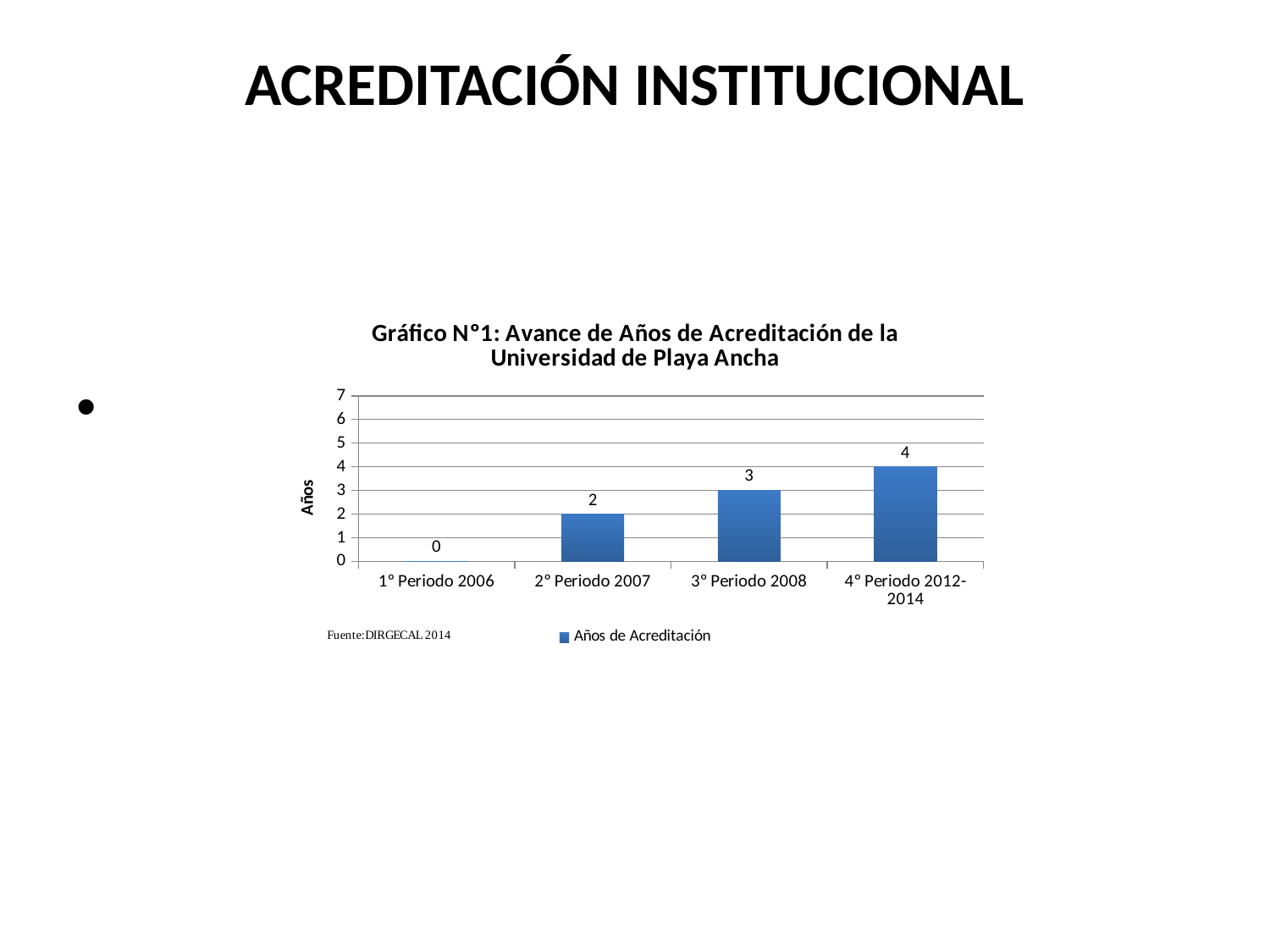
What is the label of the y axis? Años What is the value for 4° Periodo 2012-2014? 4 Which period has the highest value? 4° Periodo 2012-2014 What is the value for 2° Periodo 2007? 2 Do the values rise or fall from 1° Periodo 2006 to 4° Periodo 2012-2014? rise Which is larger, the value for 3° Periodo 2008 or the value for 2° Periodo 2007? 3° Periodo 2008 Which period has the lowest value? 1° Periodo 2006 How many periods are shown on the x axis? 4 How many series does the legend list? 1 What kind of chart is shown? bar chart What is the difference between the values for 4° Periodo 2012-2014 and 2° Periodo 2007? 2 What is the value for 1° Periodo 2006? 0